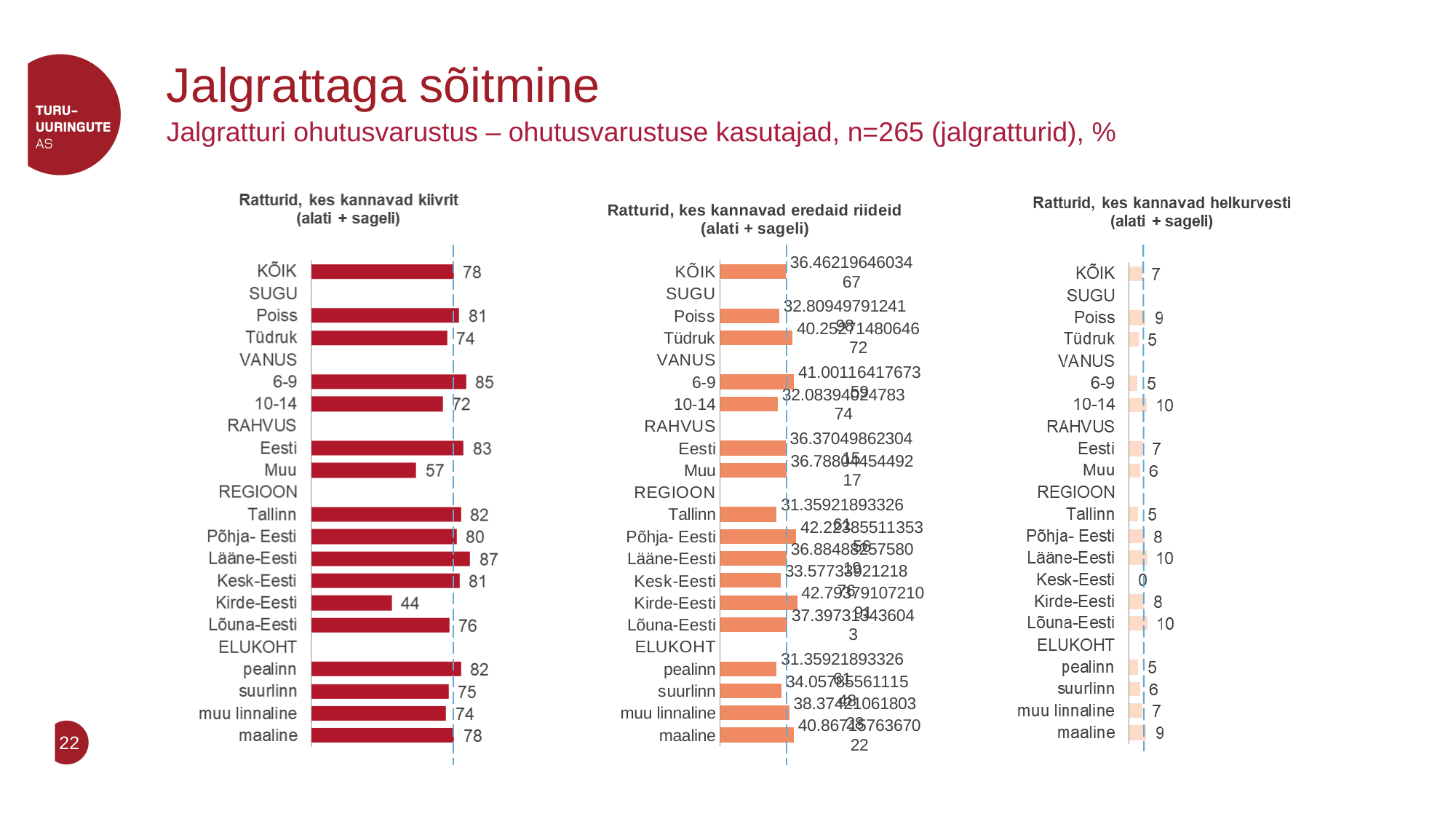
In the chart 'Ratturid, kes kannavad kiivrit (alati + sageli)', what is the value for Kirde-Eesti? 44 In the chart 'Ratturid, kes kannavad kiivrit (alati + sageli)', which category has the highest value? Lääne-Eesti In the chart 'Ratturid, kes kannavad kiivrit (alati + sageli)', what is the value for KÕIK? 78 In the chart 'Ratturid, kes kannavad helkurvesti (alati + sageli)', what is the difference between the values for Poiss and Tüdruk? 4 In the chart 'Ratturid, kes kannavad kiivrit (alati + sageli)', which is larger, the value for Eesti or the value for Muu? Eesti In the chart 'Ratturid, kes kannavad kiivrit (alati + sageli)', what is the difference between the values for Poiss and Tüdruk? 7 In the chart 'Ratturid, kes kannavad kiivrit (alati + sageli)', which category has the lowest value? Kirde-Eesti What kind of chart is 'Ratturid, kes kannavad kiivrit (alati + sageli)'? bar chart In the chart 'Ratturid, kes kannavad helkurvesti (alati + sageli)', which is larger, the value for maaline or the value for pealinn? maaline How many charts are shown on the slide? 3 In the chart 'Ratturid, kes kannavad helkurvesti (alati + sageli)', which category has the lowest value? Kesk-Eesti In the chart 'Ratturid, kes kannavad helkurvesti (alati + sageli)', what is the value for 10-14? 10